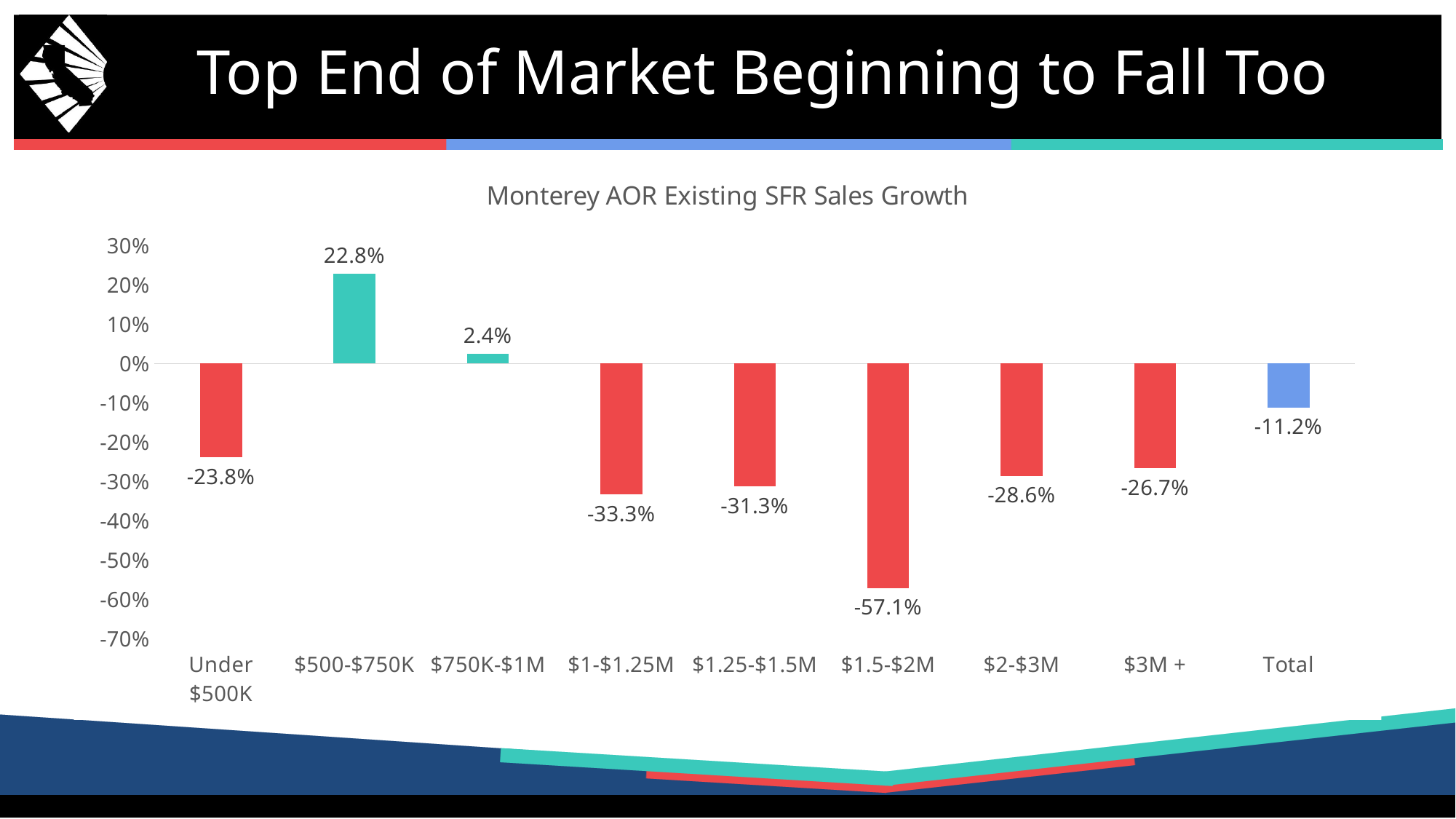
Which has a larger sales growth value, $2-$3M or $3M +? $3M + What is the sales growth value for the $500-$750K price range? 22.8% What is the title of the chart? Monterey AOR Existing SFR Sales Growth What kind of chart is shown on the slide? Bar chart What is the sales growth value for the $1.5-$2M price range? -57.1% Which price range has the lowest sales growth? $1.5-$2M What is the sales growth value for the Total category? -11.2% How many categories are shown on the x axis of the chart? 9 What is the difference between the sales growth for $1-$1.25M and $1.25-$1.5M? 2.0% Which price range has the highest sales growth? $500-$750K What is the sales growth value for the $3M + price range? -26.7% How many price ranges show positive sales growth? 2